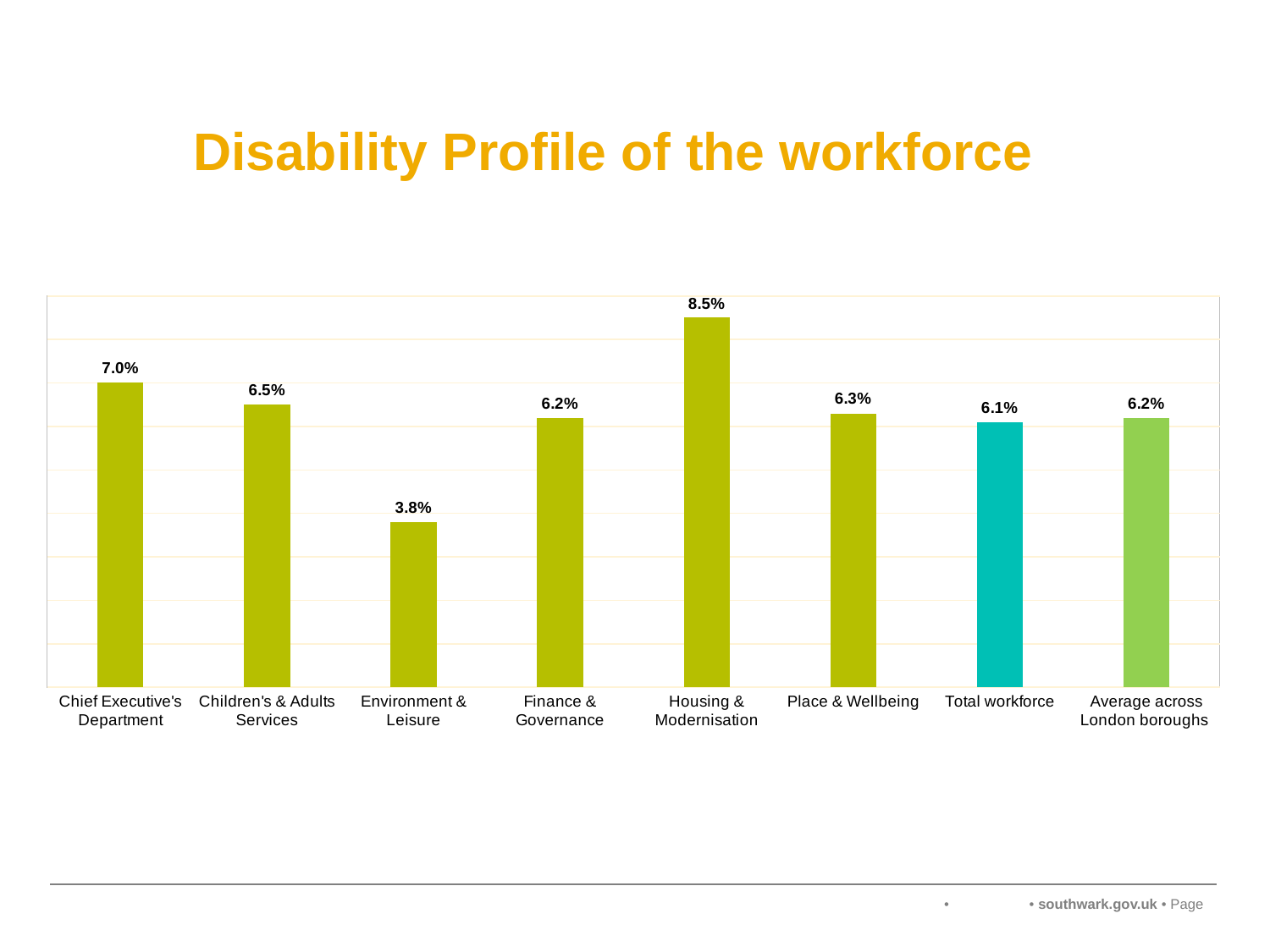
Which is larger, the value for Chief Executive's Department or the value for Children's & Adults Services? Chief Executive's Department What kind of chart is shown on the slide? Bar chart What is the value for Average across London boroughs? 6.2% What is the value for Housing & Modernisation? 8.5% What is the value for Total workforce? 6.1% What is the value for Environment & Leisure? 3.8% What is the difference between the values for Housing & Modernisation and Environment & Leisure? 4.7% Which category has the highest value? Housing & Modernisation How many categories are shown on the chart? 8 What is the difference between the values for Chief Executive's Department and Total workforce? 0.9% What is the title of the slide? Disability Profile of the workforce Which category has the lowest value? Environment & Leisure